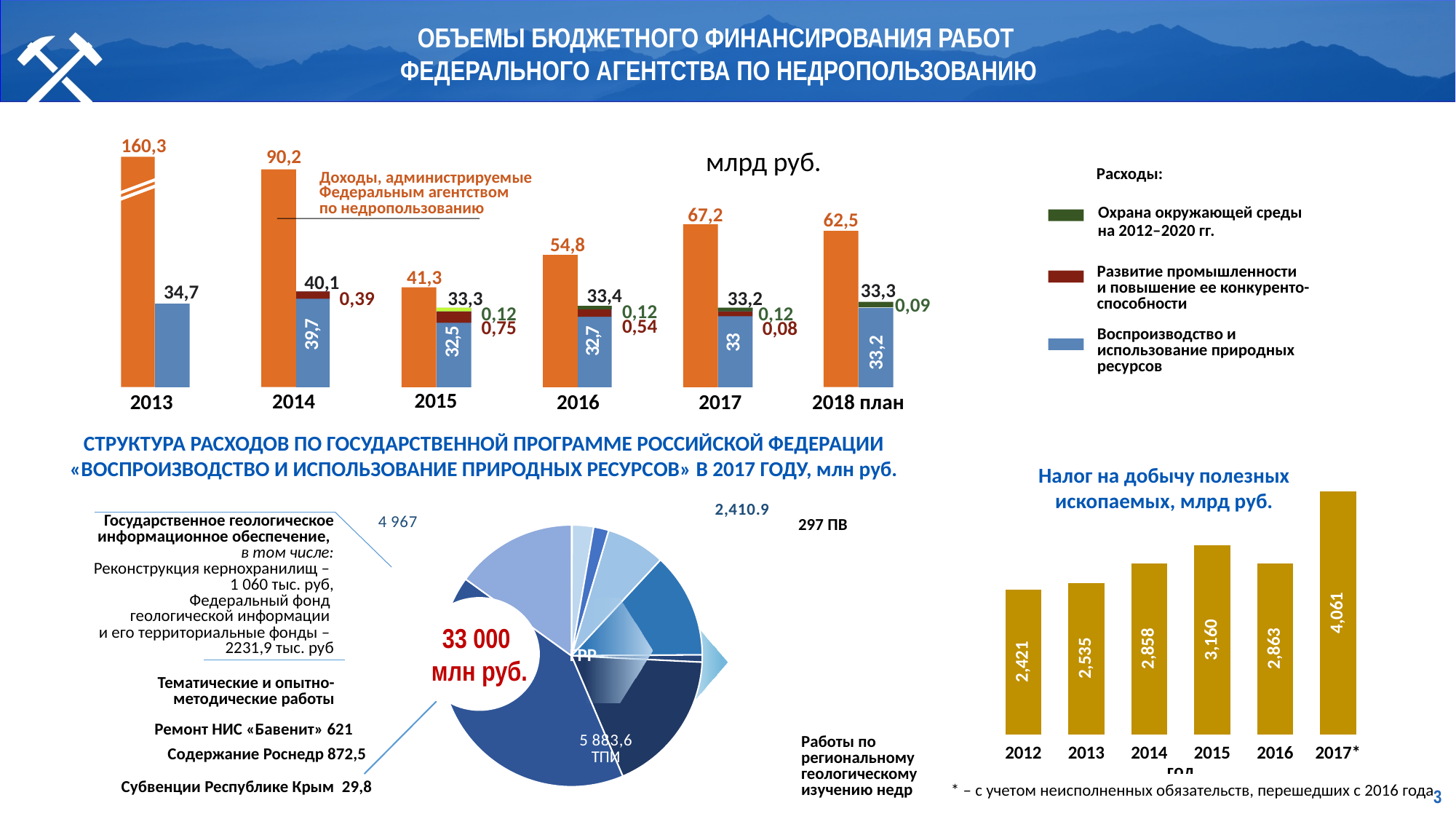
In the top chart, what is the value of the blue segment (Воспроизводство и использование природных ресурсов) for 2014? 39,7 In the top chart, how many expense categories (Расходы) does the legend list? 3 In the top chart, do the orange bar values rise or fall from 2013 to 2015? fall In the bottom-right chart (Налог на добычу полезных ископаемых), how many years are shown? 6 In the top chart, which year has the highest orange bar (Доходы)? 2013 What kind of chart is the bottom-left chart showing the structure of expenses in 2017? pie chart In the bottom-right chart (Налог на добычу полезных ископаемых), what is the difference between the values for 2015 and 2014? 0,302 In the bottom-right chart (Налог на добычу полезных ископаемых), which year has the lowest value? 2012 In the top chart, which year has the lowest orange bar (Доходы)? 2015 In the top chart, what is the difference between the orange bar values for 2017 and 2016? 12,4 In the bottom-right chart (Налог на добычу полезных ископаемых), what is the value for 2017*? 4,061 In the top chart, what is the value of the orange bar (Доходы) for 2013? 160,3